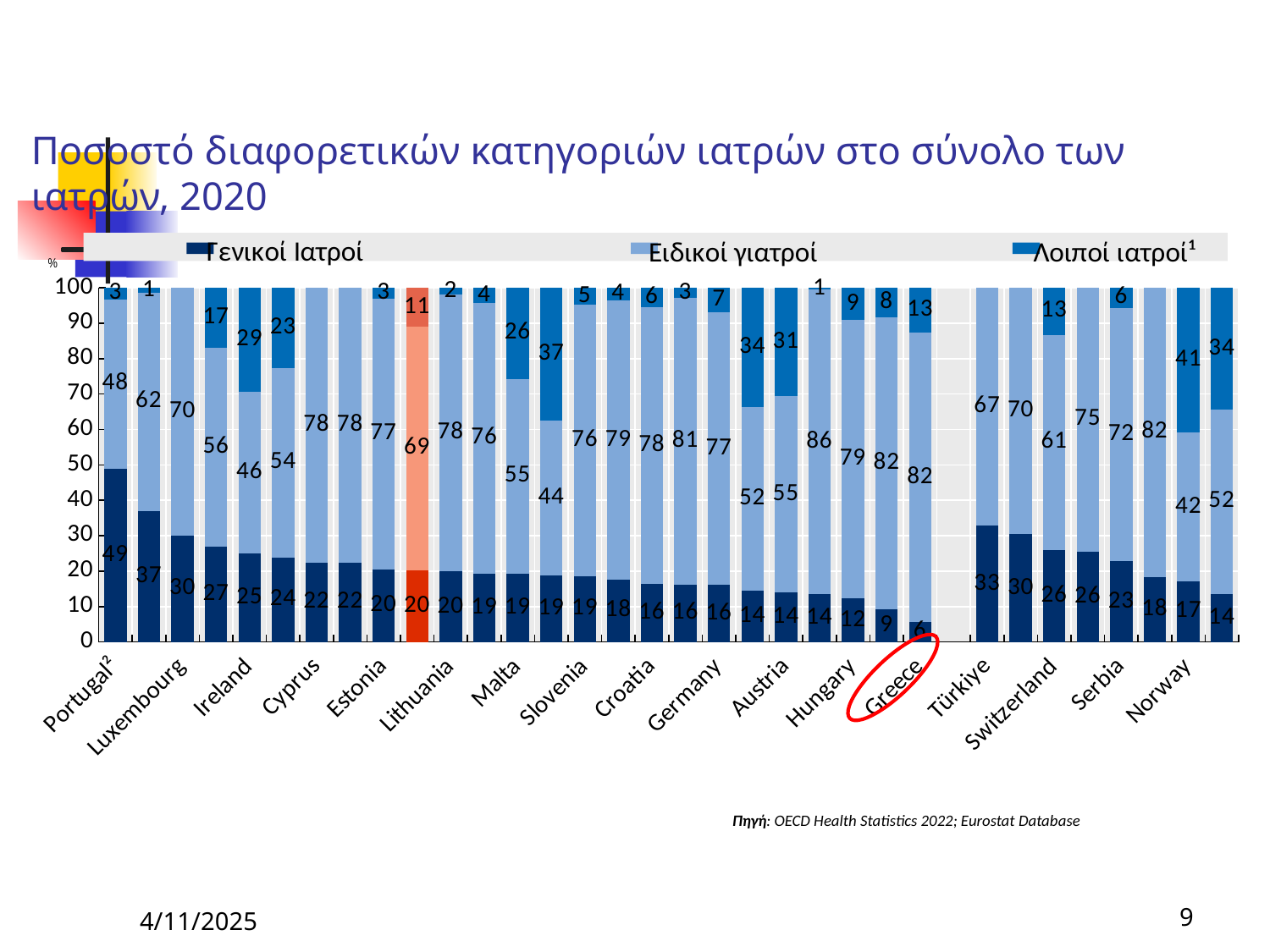
Which labelled country has the highest value for Γενικοί Ιατροί? Portugal What is the value of Λοιποί ιατροί for Norway? 41 Which labelled country has the lowest value for Γενικοί Ιατροί? Greece What is the total of the stacked bar for Norway? 100 Which country's label is circled in red on the x axis? Greece What is the difference between the Γενικοί Ιατροί value for Portugal and for Greece? 43 How many series does the legend list? 3 What is the value of Ειδικοί γιατροί for Portugal? 48 What is the value of Γενικοί Ιατροί for Greece? 6 Which has a larger Γενικοί Ιατροί value, Türkiye or Switzerland? Türkiye What kind of chart is shown on the slide? Stacked bar chart What is the value of Λοιποί ιατροί for Malta? 26